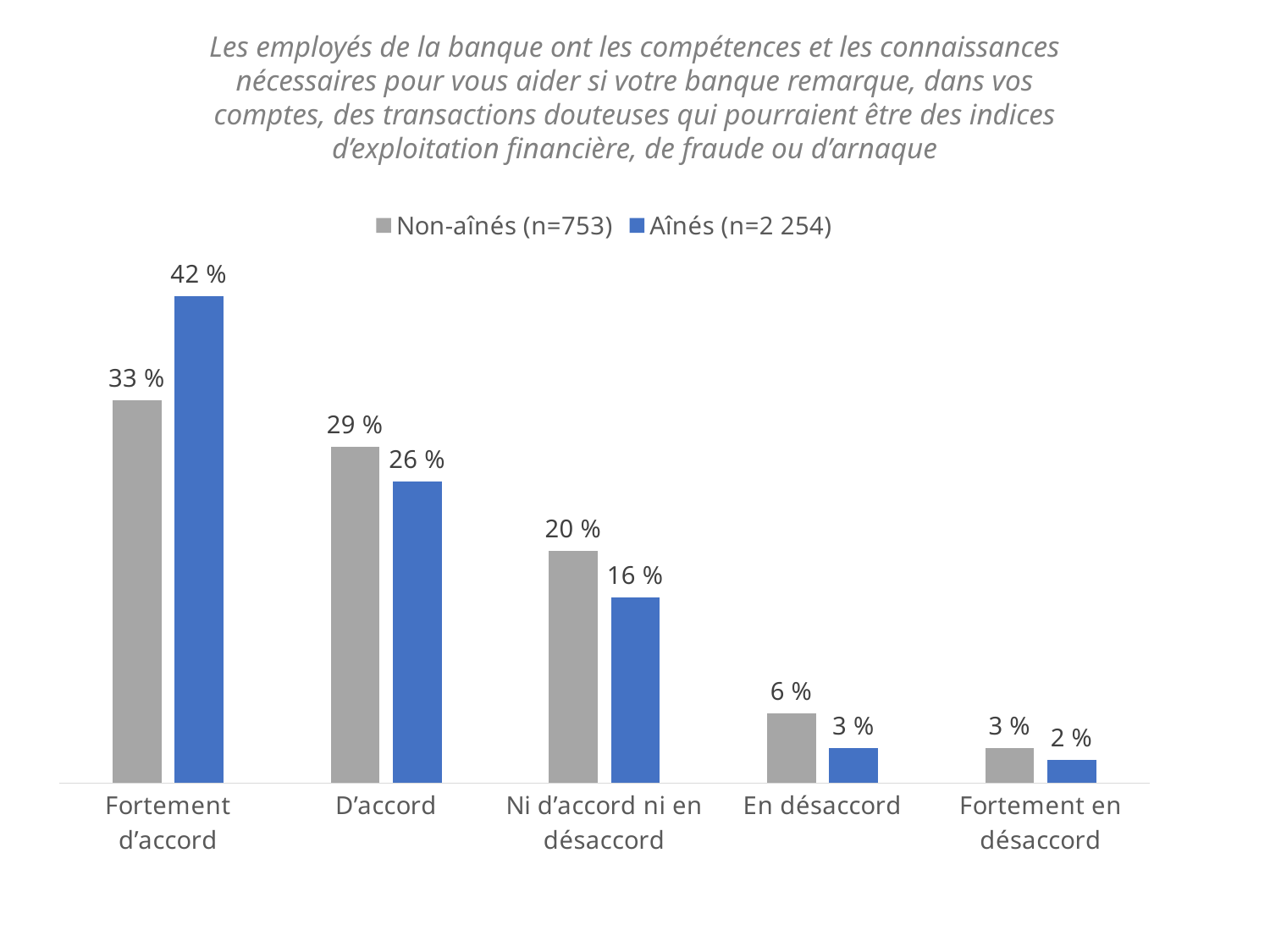
What is the difference between the Aînés (n=2 254) and Non-aînés (n=753) values in the Fortement d'accord category? 9 % What is the value for Aînés (n=2 254) in the Fortement d'accord category? 42 % Which colour represents the Aînés (n=2 254) series? Blue Which category has the highest value for Aînés (n=2 254)? Fortement d'accord What is the value for Non-aînés (n=753) in the Fortement en désaccord category? 3 % What kind of chart is shown on the slide? Bar chart In the D'accord category, which series has the larger value, Non-aînés (n=753) or Aînés (n=2 254)? Non-aînés (n=753) How many categories are shown on the x axis? 5 What is the value for Aînés (n=2 254) in the Ni d'accord ni en désaccord category? 16 % What is the value for Non-aînés (n=753) in the D'accord category? 29 % Which category has the lowest value for Non-aînés (n=753)? Fortement en désaccord How many series does the legend list? 2